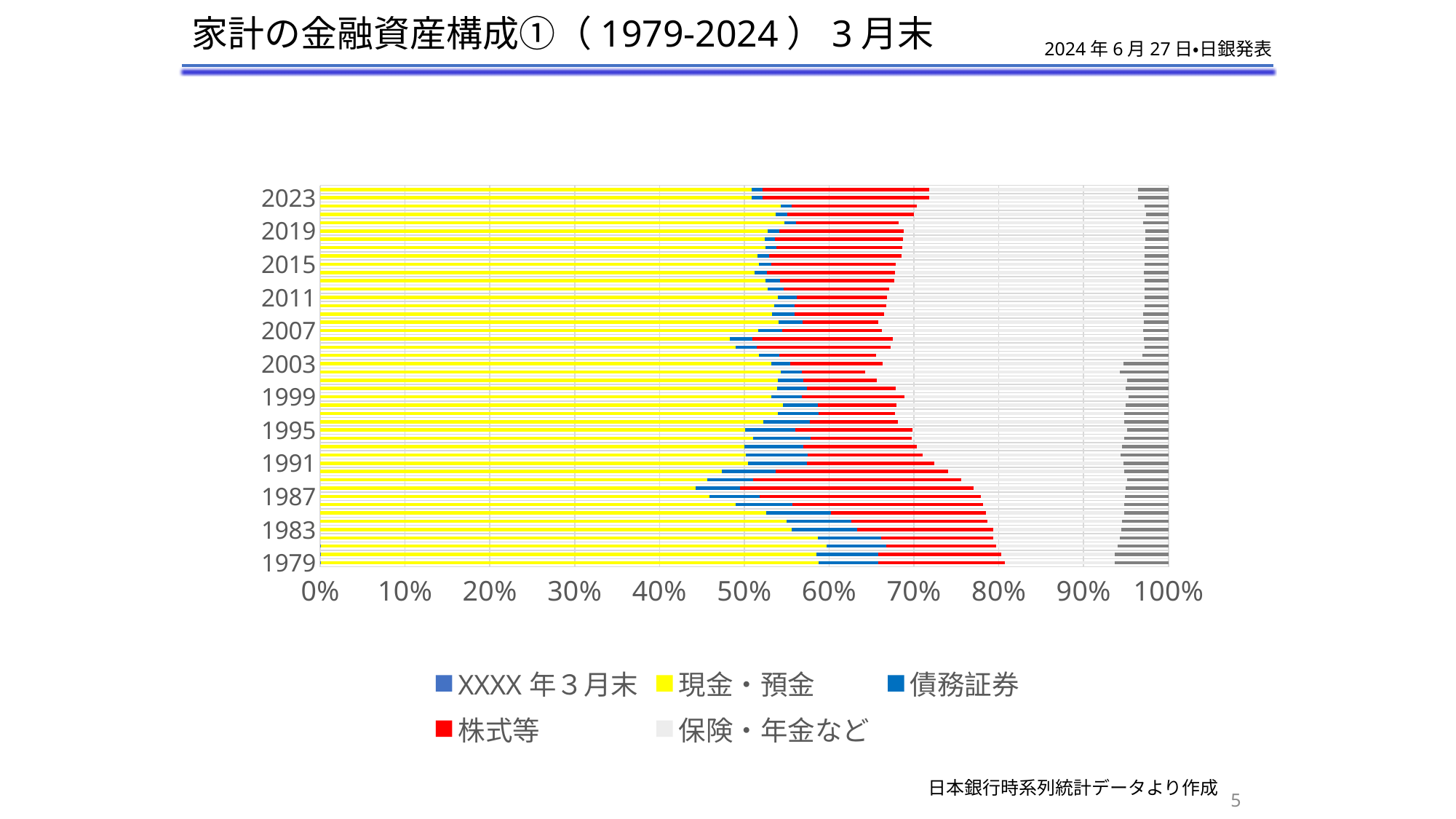
How many years (bars) are plotted in the chart? 46 Which year has the larger 現金・預金 share, 1979 or 1987? 1979 Is the 現金・預金 share for 1979 greater or less than 50%? greater Which colour represents 株式等 in the chart? Red Which year has the larger 現金・預金 share, 1987 or 2011? 2011 Is the 現金・預金 share for 1987 greater or less than 50%? less What kind of chart is shown on the slide? Stacked horizontal bar chart What is the title of the chart on the slide? 家計の金融資産構成①（1979-2024）3月末 How many series does the legend list? 5 Is the 現金・預金 share for 2011 greater or less than 50%? greater What is the highest value shown on the horizontal axis? 100%